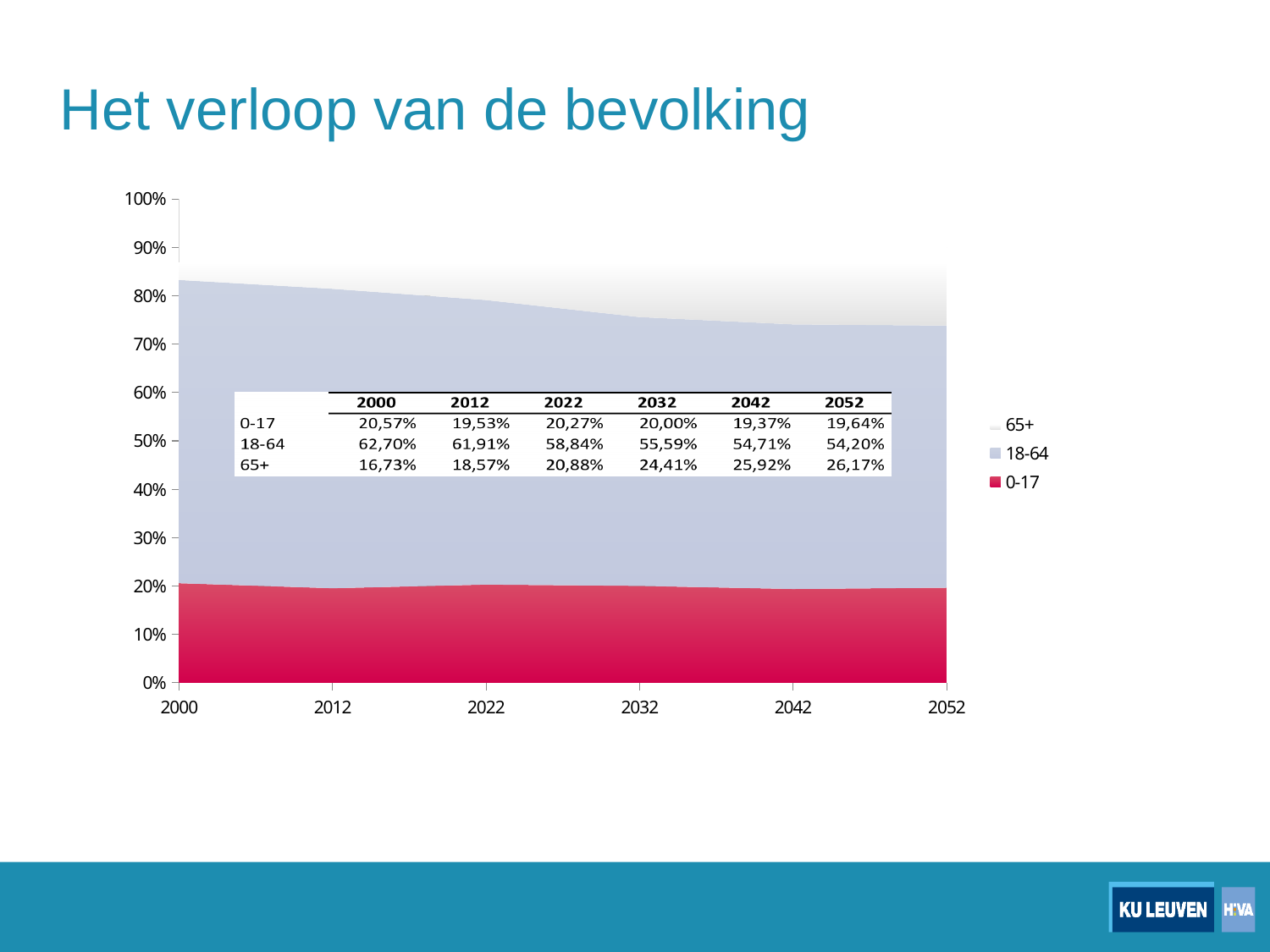
What is the value for the 65+ series in 2052? 26,17% In 2000, which is larger: the 0-17 share or the 65+ share? 0-17 In which year is the 18-64 share the lowest? 2052 What is the difference between the 18-64 share in 2000 and in 2052? 8,50% In which year is the 65+ share the highest? 2052 How many series does the legend list? 3 By how much does the 65+ share in 2052 exceed the 65+ share in 2000? 9,44% How many years are shown on the x axis? 6 What is the value for the 0-17 series in 2000? 20,57% What kind of chart is shown on the slide? stacked area chart What is the value for the 18-64 series in 2022? 58,84% Does the 18-64 share rise or fall from 2000 to 2052? fall